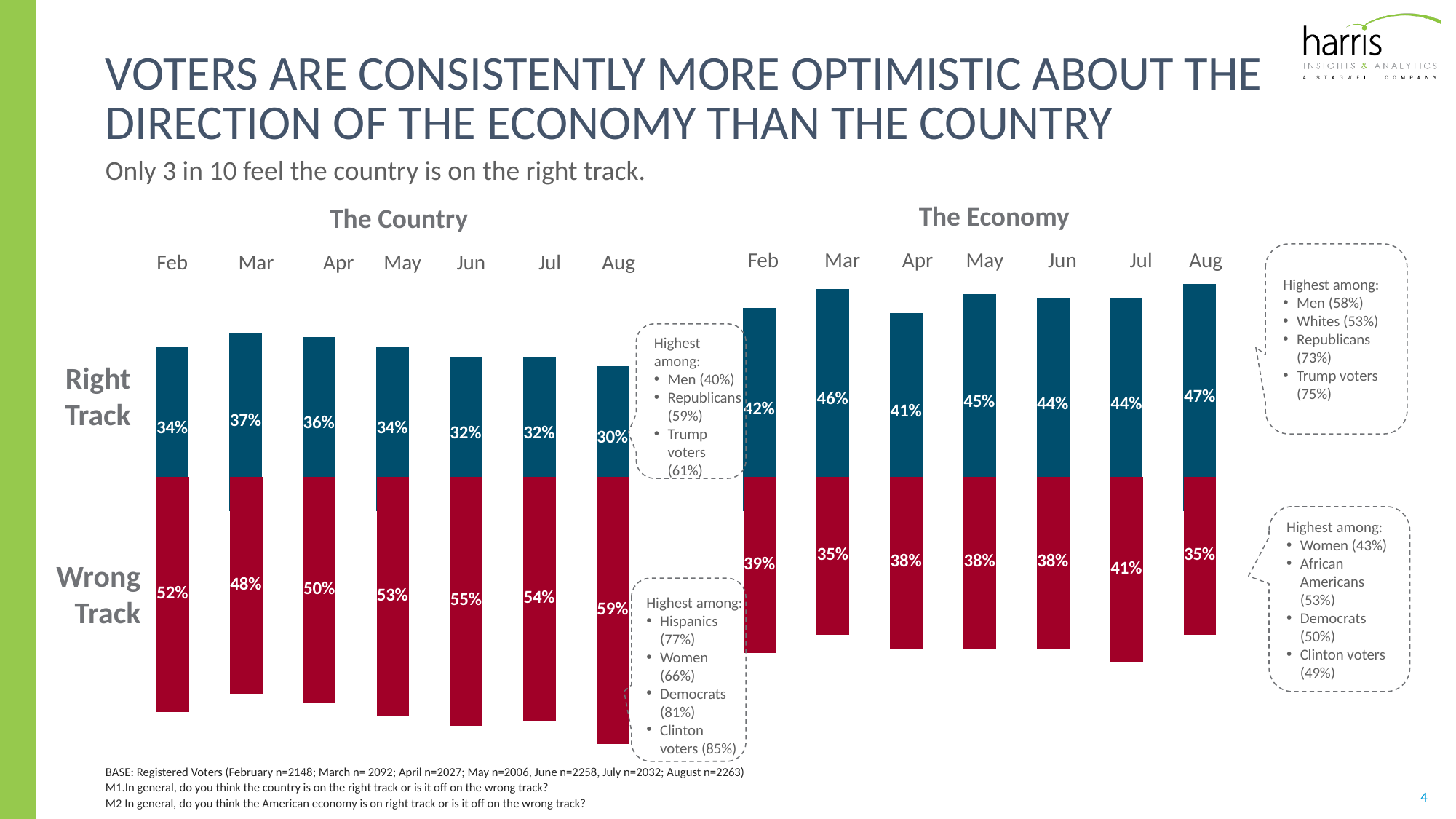
In The Economy chart, which month has the lowest Right Track value? Apr In The Economy chart, what is the Right Track value for Aug? 47% What colour are the Wrong Track bars in both charts? red How many months are shown in The Country chart? 7 In The Economy chart, which is larger, the Right Track value for Mar or the Right Track value for May? Mar In The Economy chart, what is the Wrong Track value for Jul? 41% In The Country chart, which month has the highest Wrong Track value? Aug What type of chart is The Economy chart? bar chart In The Country chart, what is the Right Track value for Aug? 30% In The Country chart, does the Right Track value rise or fall from Mar to Aug? fall In The Country chart, what is the difference between the Wrong Track values for Aug and Mar? 11% In The Country chart, what is the difference between the Wrong Track and Right Track values for Feb? 18%